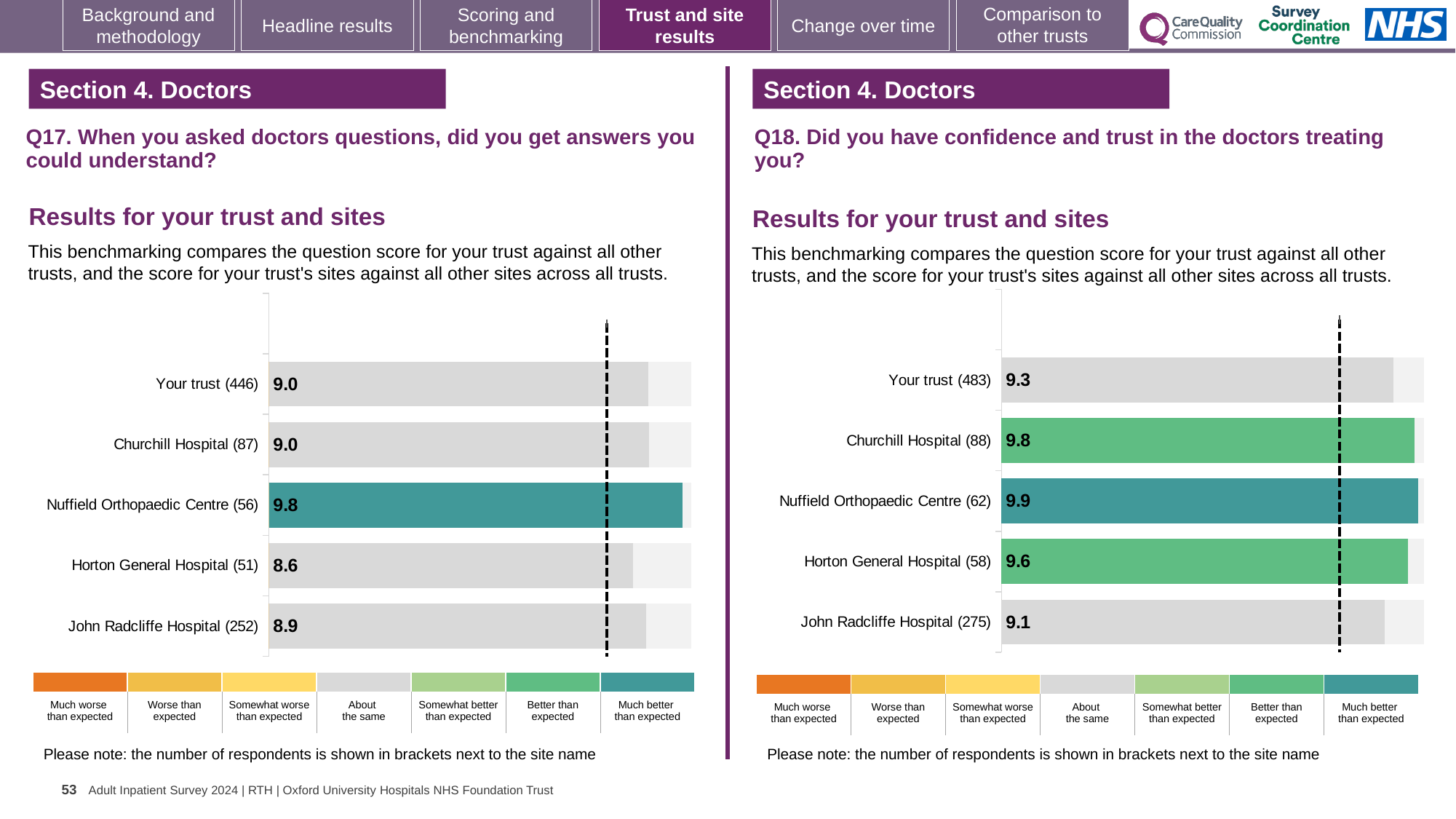
In the Q18 chart on the right, which site has the highest score? Nuffield Orthopaedic Centre In the Q17 chart on the left, what is the difference between the scores for Nuffield Orthopaedic Centre and Horton General Hospital? 1.2 In the Q17 chart on the left, which site has the lowest score? Horton General Hospital How many bars are plotted in the Q17 chart on the left? 5 In the Q18 chart on the right, which has the higher score, Horton General Hospital or Your trust? Horton General Hospital In the Q18 chart on the right, what is the difference between the scores for Churchill Hospital and John Radcliffe Hospital? 0.7 In the Q17 chart on the left, what is the score for Nuffield Orthopaedic Centre? 9.8 In the Q17 chart on the left, what is the score for Horton General Hospital? 8.6 In the Q18 chart on the right, what is the score for John Radcliffe Hospital? 9.1 In the Q17 chart on the left, how many respondents are shown in brackets for John Radcliffe Hospital? 252 What kind of chart is used for the Q18 results on the right? Bar chart In the Q18 chart on the right, what is the score for Your trust? 9.3